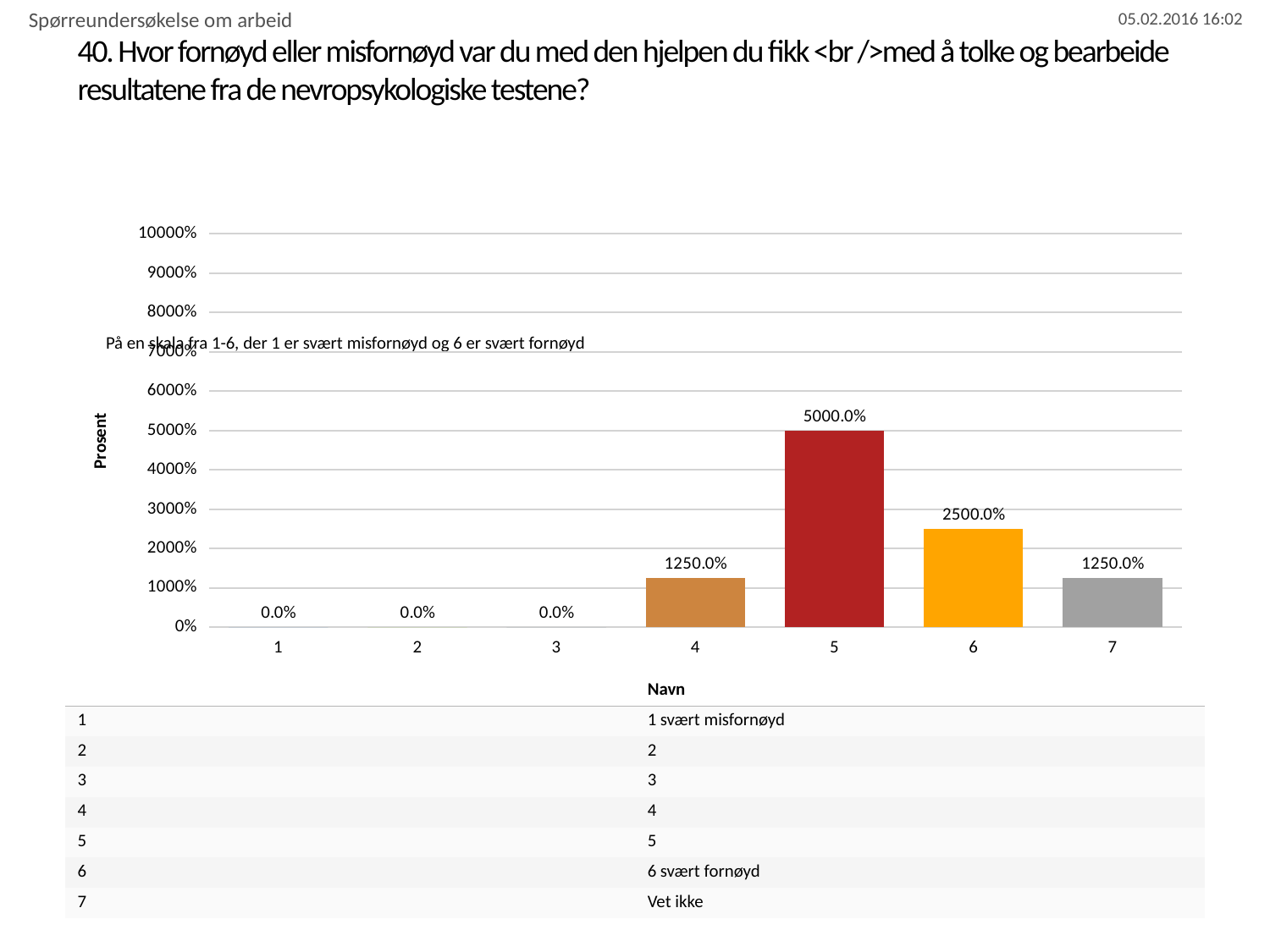
What is the label of the y axis? Prosent Which category has the highest value? 5 Which is larger, the value for category 6 or the value for category 7? 6 How many categories are shown on the x axis? 7 What is the value for category 6? 2500.0% What is the value for category 5? 5000.0% What kind of chart is shown? bar chart What is the value for category 1? 0.0% What is the difference between the values for category 5 and category 6? 2500.0% What is the value for category 4? 1250.0% How many categories have a value of 0.0%? 3 Is the value for category 5 greater or less than 4000%? greater